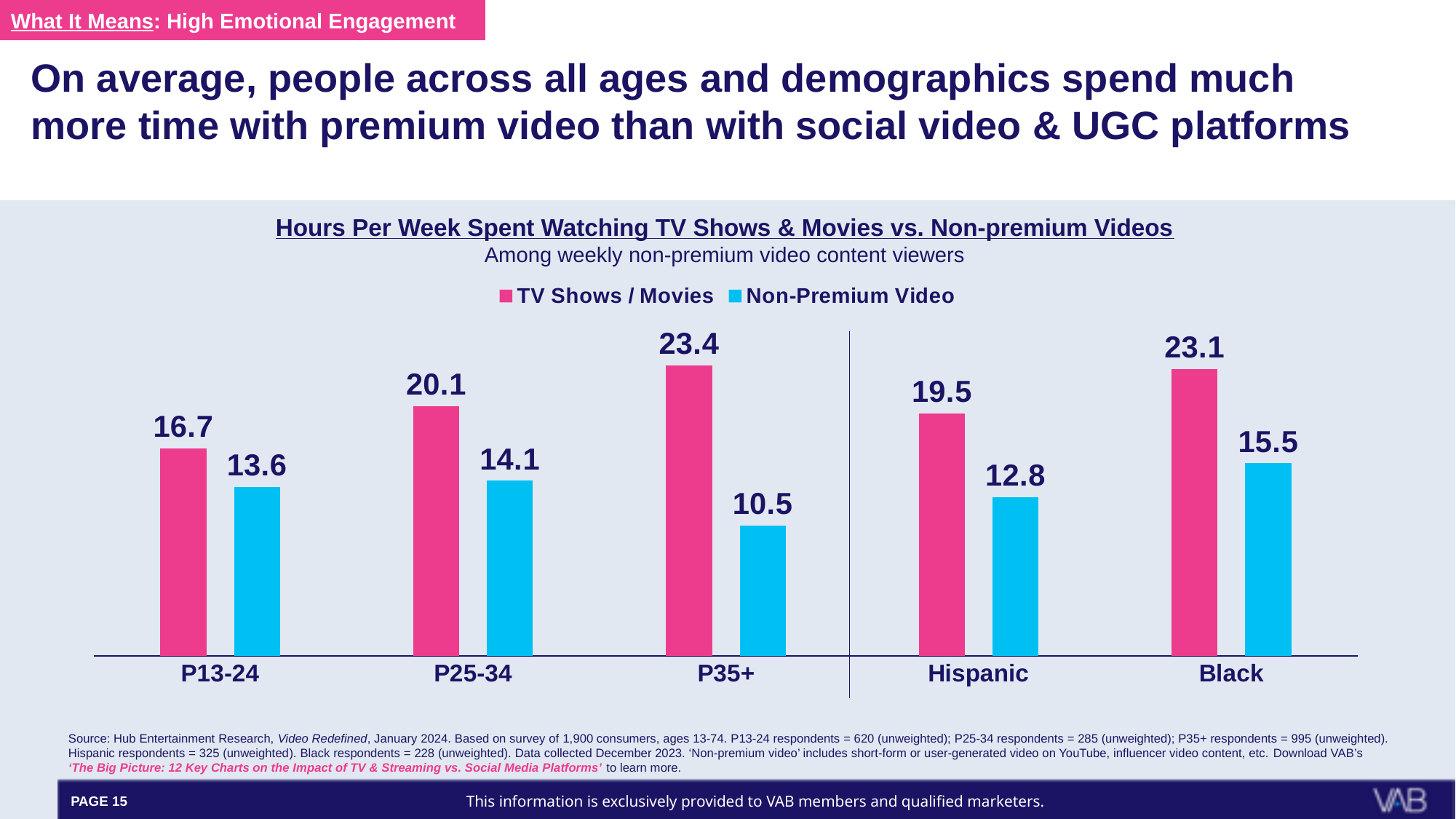
What kind of chart is shown on the slide? Bar chart How many categories are shown on the x axis? 5 Which is larger, the Non-Premium Video value for Black or for P25-34? Black Which category has the lowest Non-Premium Video value? P35+ How many series does the legend list? 2 What is the value for Non-Premium Video for Hispanic? 12.8 What is the difference between TV Shows / Movies and Non-Premium Video for P35+? 12.9 Which category has the highest TV Shows / Movies value? P35+ What is the value for TV Shows / Movies for P35+? 23.4 What is the value for Non-Premium Video for P13-24? 13.6 Which colour represents Non-Premium Video in the chart? Blue What is the difference between the TV Shows / Movies values for Black and Hispanic? 3.6